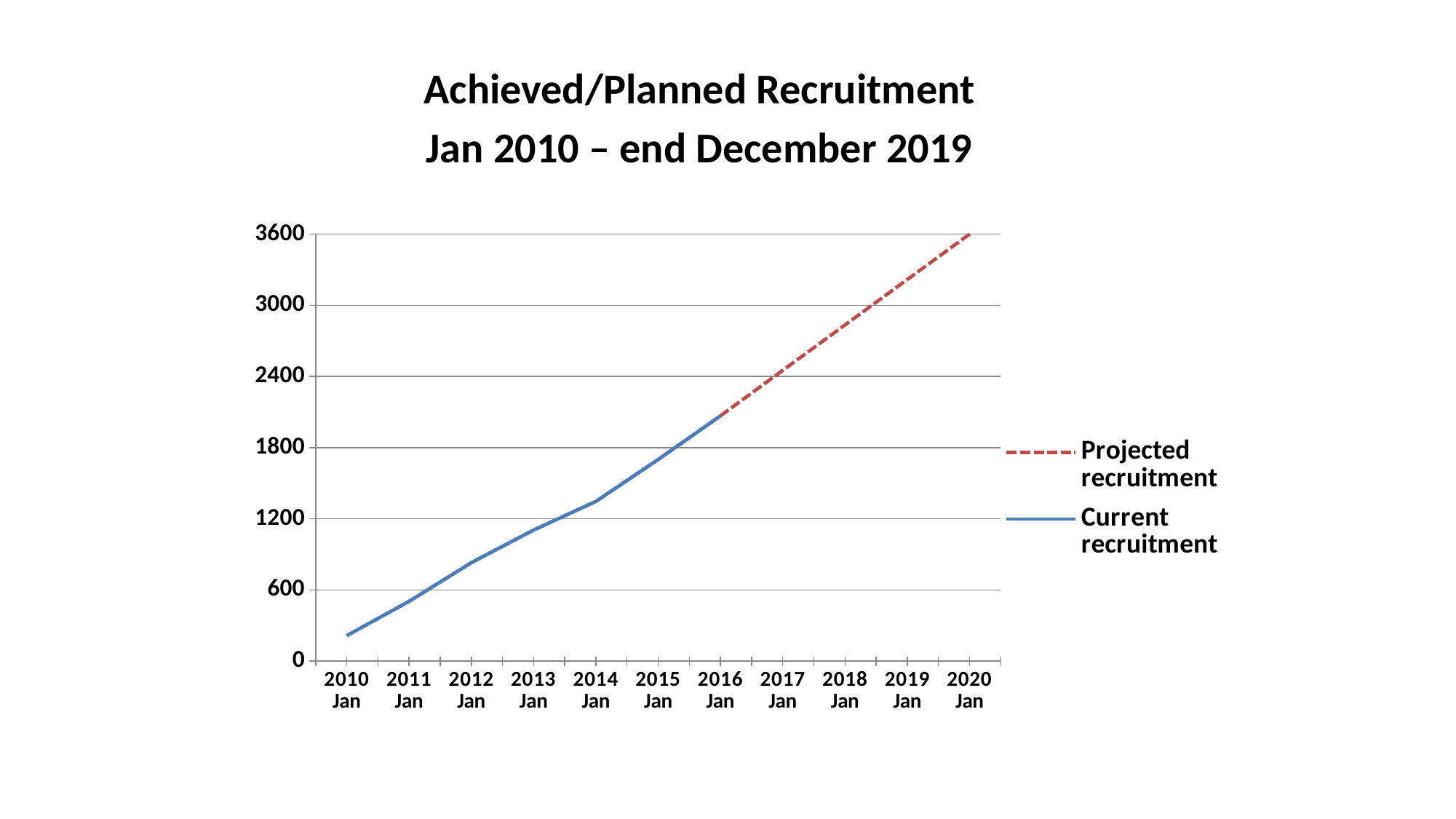
Is the value for current recruitment at 2014 Jan greater or less than 1200? greater How many series does the legend list? 2 Is the value for current recruitment at 2016 Jan greater or less than 1800? greater What value does projected recruitment reach at 2020 Jan? 3600 What kind of chart is shown on the slide? line chart How many points are labelled on the x axis? 11 Does current recruitment rise or fall from 2010 Jan to 2016 Jan? rise Is the value for current recruitment at 2012 Jan greater or less than 600? greater What is the title of the chart? Achieved/Planned Recruitment Jan 2010 – end December 2019 Which series is drawn with a dashed line? Projected recruitment